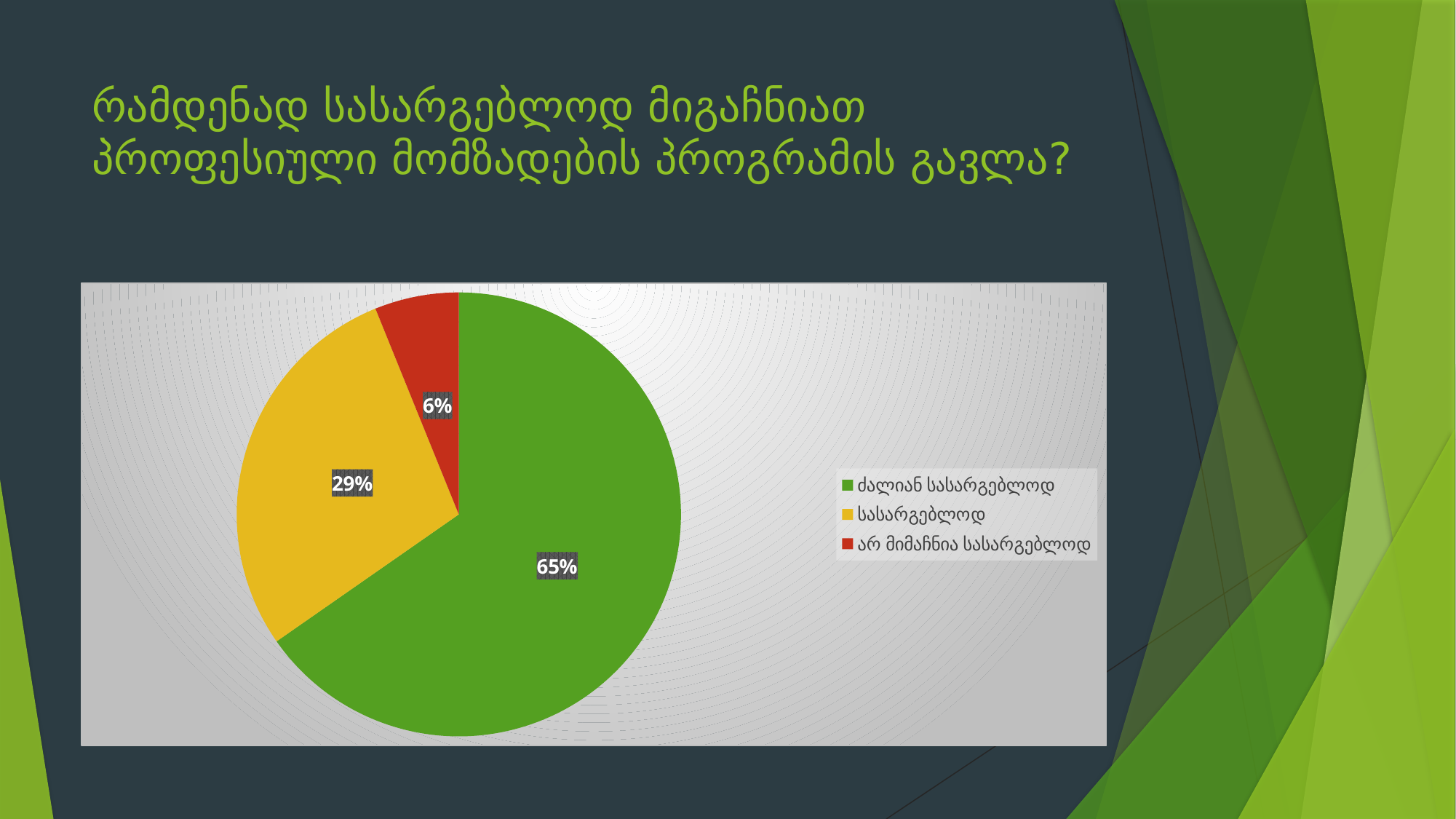
What percentage is shown for the slice labelled "სასარგებლოდ"? 29% Which category has the smallest slice of the pie? არ მიმაჩნია სასარგებლოდ What colour is the slice for "სასარგებლოდ"? yellow What is the difference in percentage points between the "სასარგებლოდ" slice and the "არ მიმაჩნია სასარგებლოდ" slice? 23 Which is larger: the "სასარგებლოდ" slice or the "არ მიმაჩნია სასარგებლოდ" slice? სასარგებლოდ Which category has the largest slice of the pie? ძალიან სასარგებლოდ What colour is the slice for "არ მიმაჩნია სასარგებლოდ"? red What is the difference in percentage points between the "ძალიან სასარგებლოდ" slice and the "სასარგებლოდ" slice? 36 What percentage is shown for the slice labelled "არ მიმაჩნია სასარგებლოდ"? 6% What kind of chart is shown on the slide? pie chart How many slices does the pie chart have? 3 What percentage is shown for the slice labelled "ძალიან სასარგებლოდ"? 65%